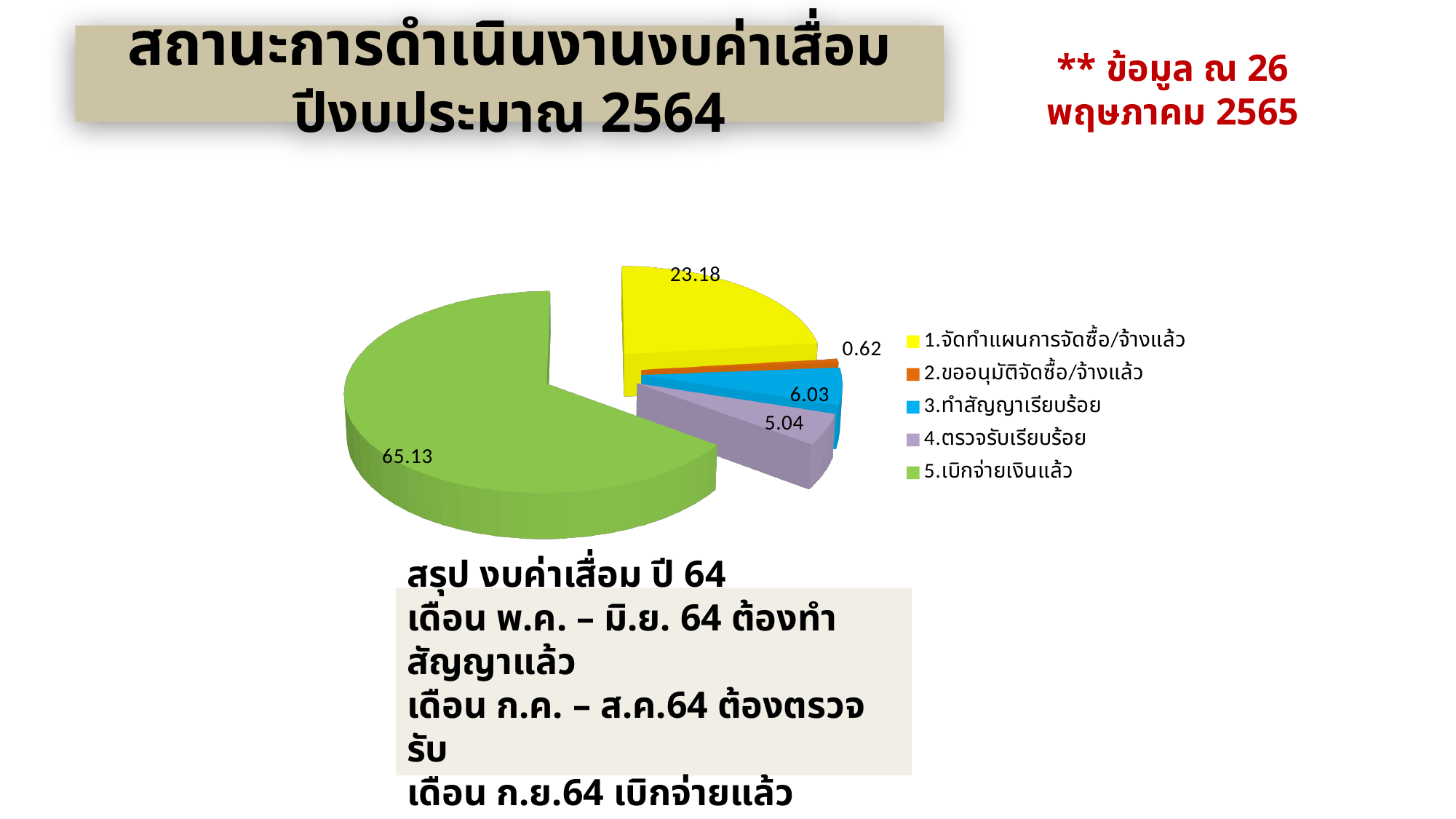
What is the value shown for 1.จัดทำแผนการจัดซื้อ/จ้างแล้ว in the pie chart? 23.18 What colour is the slice for 5.เบิกจ่ายเงินแล้ว in the pie chart? green What is the difference between the values for 5.เบิกจ่ายเงินแล้ว and 1.จัดทำแผนการจัดซื้อ/จ้างแล้ว? 41.95 What is the value shown for 3.ทำสัญญาเรียบร้อย in the pie chart? 6.03 What is the value shown for 5.เบิกจ่ายเงินแล้ว in the pie chart? 65.13 How many slices does the pie chart have? 5 Which category has the smallest slice in the pie chart? 2.ขออนุมัติจัดซื้อ/จ้างแล้ว Which is larger, the value for 3.ทำสัญญาเรียบร้อย or the value for 4.ตรวจรับเรียบร้อย? 3.ทำสัญญาเรียบร้อย How many entries does the legend of the pie chart list? 5 What is the value shown for 4.ตรวจรับเรียบร้อย in the pie chart? 5.04 Which category has the largest slice in the pie chart? 5.เบิกจ่ายเงินแล้ว What kind of chart is shown on the slide? pie chart